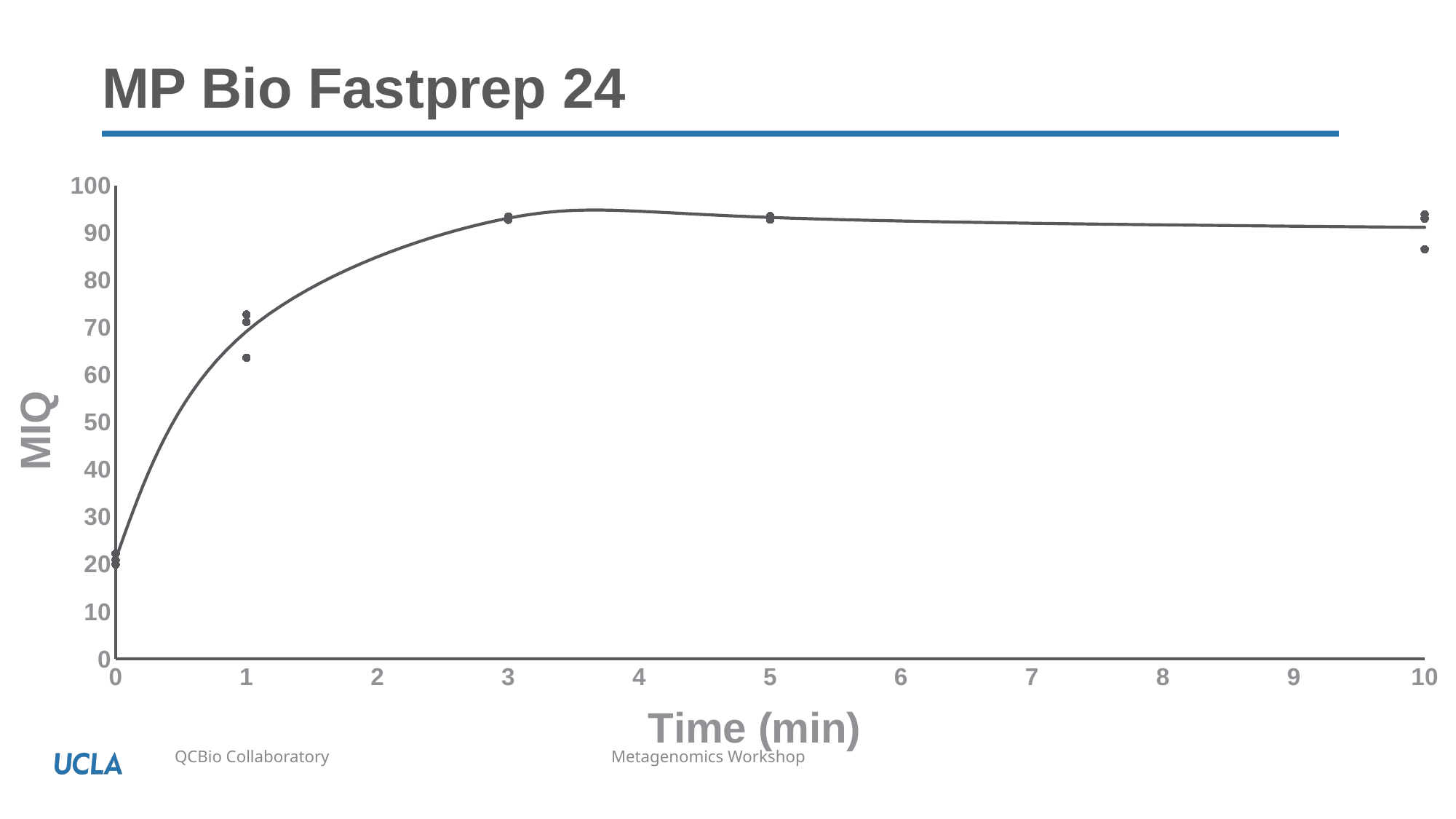
Are the MIQ values at time 0 min greater or less than 30? less At which time point are the MIQ values lowest? 0 min What is the label of the y axis? MIQ Is the MIQ value at time 3 min greater or less than 90? greater How many distinct time points have data points plotted? 5 Is the MIQ value at time 5 min greater or less than 80? greater Which has the higher MIQ value: time 1 min or time 3 min? 3 min How does MIQ change as time increases from 0 to 3 min? It rises What kind of chart is shown on the slide? Scatter plot with a fitted curve What is the title of the chart on the slide? MP Bio Fastprep 24